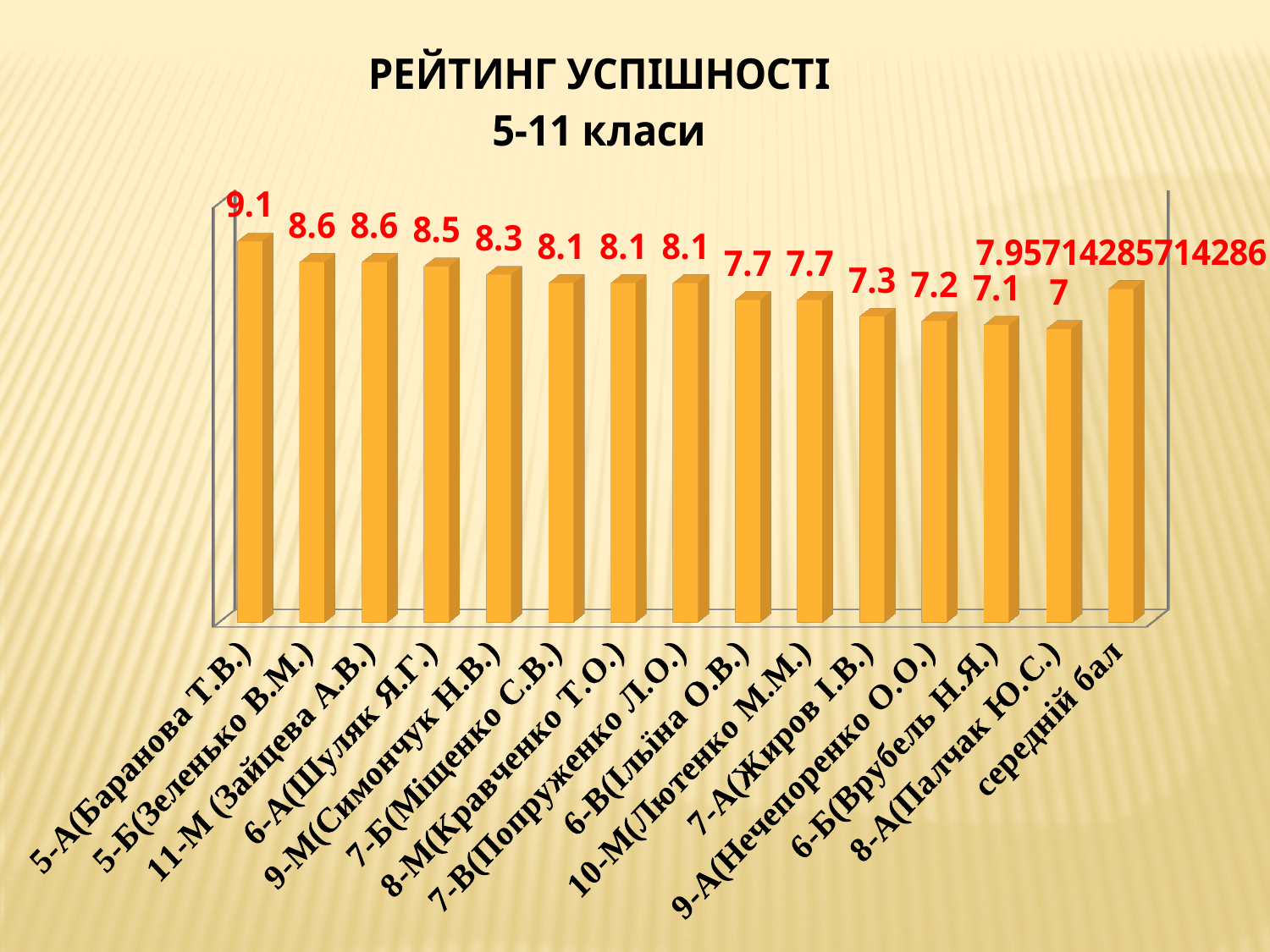
What is the value for 5-А(Баранова Т.В.)? 9.1 Which category has the lowest value? 8-А(Палчак Ю.С.) Which is larger, the value for 5-Б(Зеленько В.М.) or the value for 6-Б(Врубель Н.Я.)? 5-Б(Зеленько В.М.) Which category has the highest value? 5-А(Баранова Т.В.) What is the value for 9-М(Симончук Н.В.)? 8.3 What kind of chart is shown on the slide? bar chart What is the difference between the values for 6-А(Шуляк Я.Г.) and 7-А(Жиров І.В.)? 1.2 What is the value for 8-А(Палчак Ю.С.)? 7 What is the value shown for середній бал? 7.95714285714286 What is the title of the chart? РЕЙТИНГ УСПІШНОСТІ 5-11 класи What is the difference between the values for 5-А(Баранова Т.В.) and 8-А(Палчак Ю.С.)? 2.1 How many bars are plotted on the chart? 15